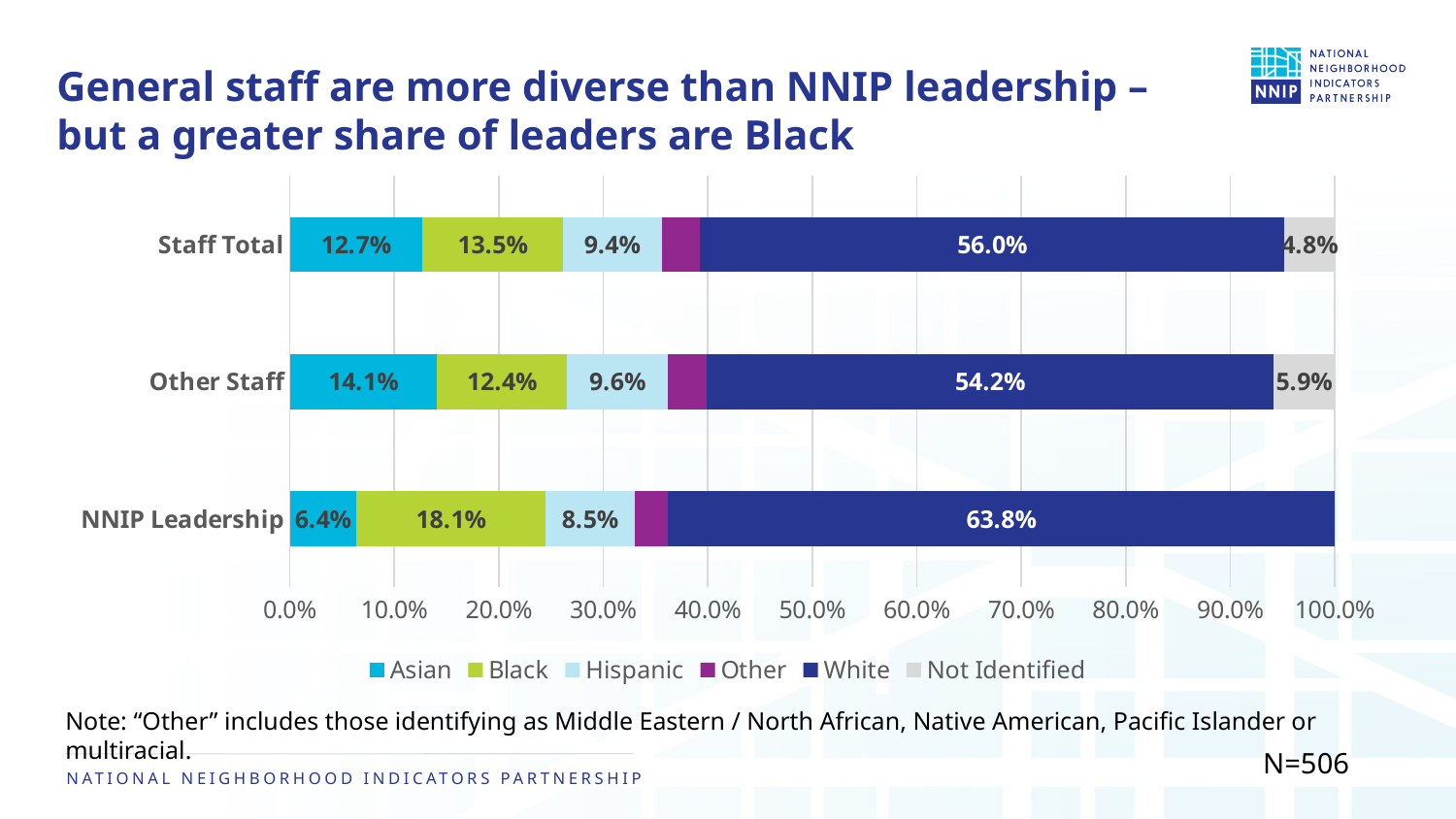
What is the Asian share for Other Staff? 14.1% What kind of chart is shown on the slide? Stacked bar chart How many series does the legend list? 6 What is the difference between the Black share for NNIP Leadership and the Black share for Staff Total? 4.6% What is the Not Identified share for Other Staff? 5.9% Which group has the lowest Asian share? NNIP Leadership Which group has the highest Black share? NNIP Leadership What is the White share for NNIP Leadership? 63.8% Which legend entry is shown in dark blue? White What is the Black share for Staff Total? 13.5% Which is larger: the Hispanic share for Other Staff or the Hispanic share for NNIP Leadership? Other Staff How many groups (bars) are shown in the chart? 3